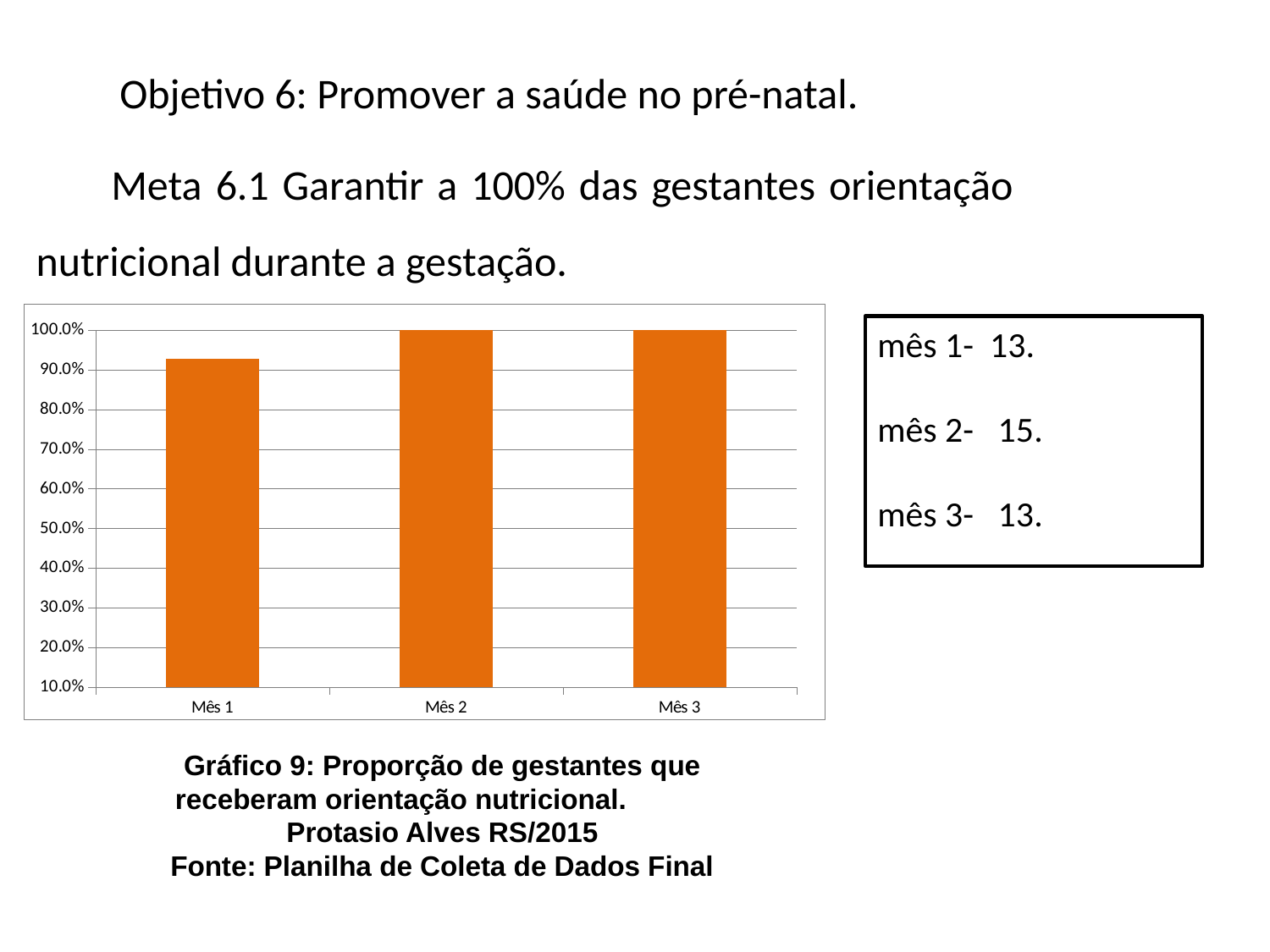
What is the value for Mês 3 in the chart? 100.0% Does the value rise or fall from Mês 1 to Mês 2? Rise What is the value for Mês 2 in the chart? 100.0% How many months (categories) are shown in the chart? 3 Which month has the lowest value in the chart? Mês 1 What is the highest value shown on the vertical axis of the chart? 100.0% What colour are the bars in the chart? Orange What kind of chart is shown on the slide? Bar chart Is the value for Mês 1 greater or less than 90.0%? greater Is the value for Mês 1 greater or less than 100.0%? less Which is larger, the value for Mês 1 or the value for Mês 2? Mês 2